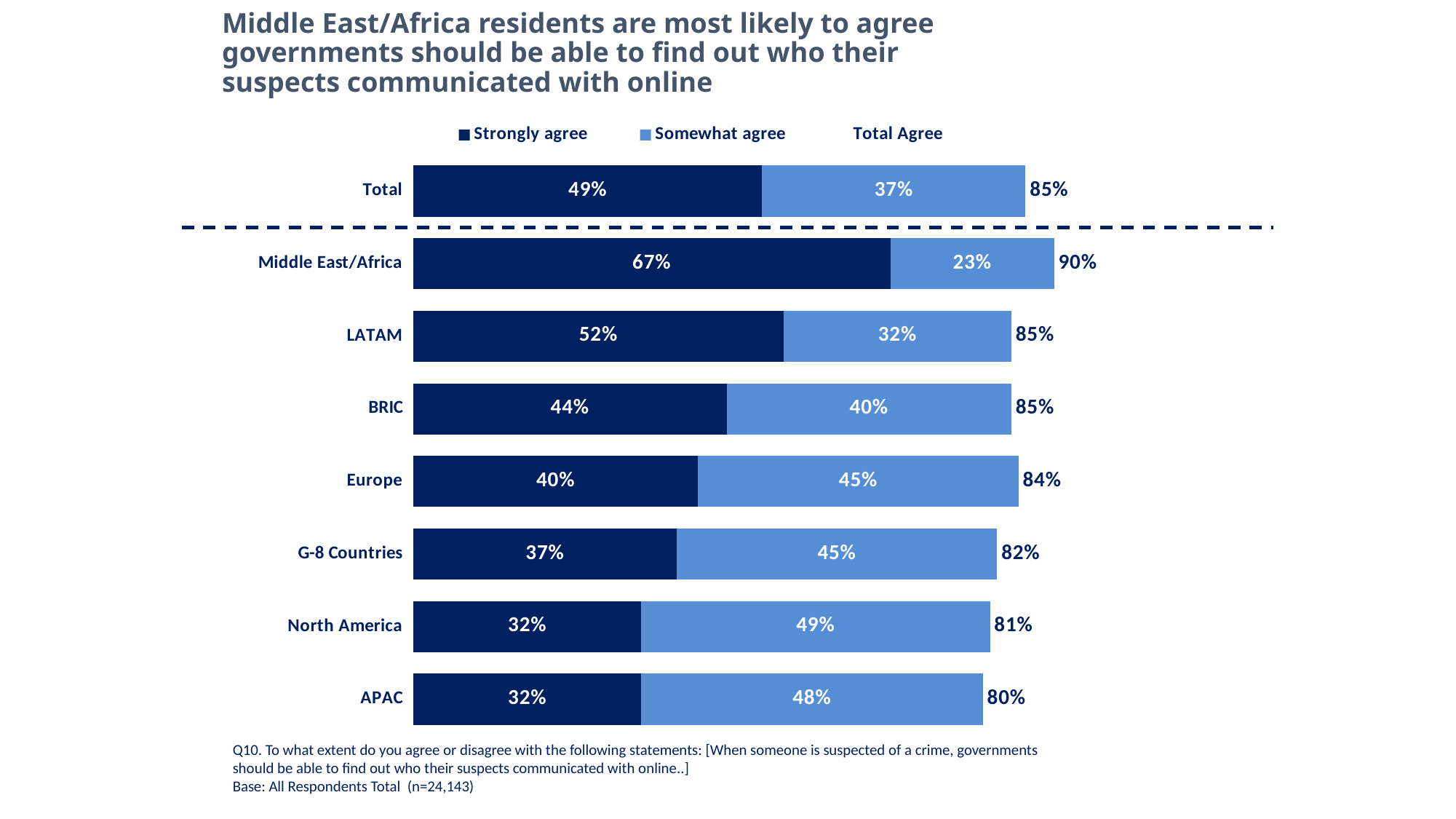
What is the Total Agree value for APAC? 80% What is the Total Agree value for G-8 Countries? 82% What is the Strongly agree value for the Total bar? 49% How many series have a coloured marker in the legend? 2 What kind of chart is shown on the slide? Stacked bar chart What is the Strongly agree value for Middle East/Africa? 67% What is the Somewhat agree value for North America? 49% Which is larger, the Somewhat agree value for Europe or for Middle East/Africa? Europe What is the difference between the Strongly agree values for LATAM and BRIC? 8% Which region has the highest Strongly agree value? Middle East/Africa Which region has the lowest Total Agree value? APAC How many bars are shown in the chart, including the Total bar? 8